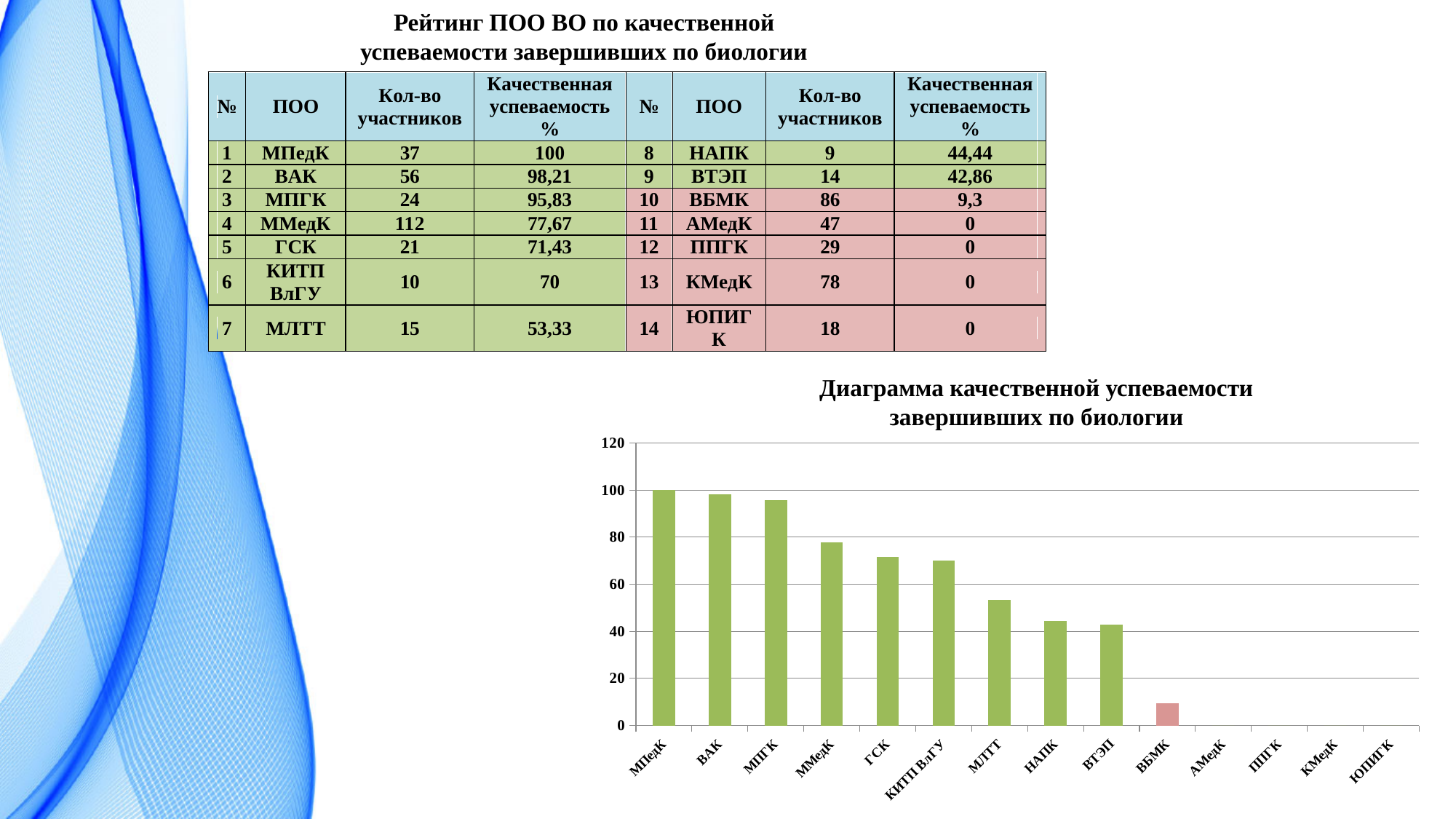
Is the value for ММедК in the chart greater or less than 60? greater Is the value for ГСК in the chart greater or less than 80? less Which bar in the chart is coloured differently (pink) from the green bars? ВБМК In the chart, which is larger, the value for ММедК or the value for ГСК? ММедК Which category has the highest bar in the chart? МПедК Is the value for ВБМК in the chart greater or less than 20? less How many categories are shown on the x axis of the bar chart? 14 According to the table, what is the качественная успеваемость % for ВБМК? 9,3 Do the bar values rise or fall from left to right along the x axis of the chart? fall What kind of chart is shown under the title 'Диаграмма качественной успеваемости завершивших по биологии'? bar chart What is the value for МПедК in the chart? 100